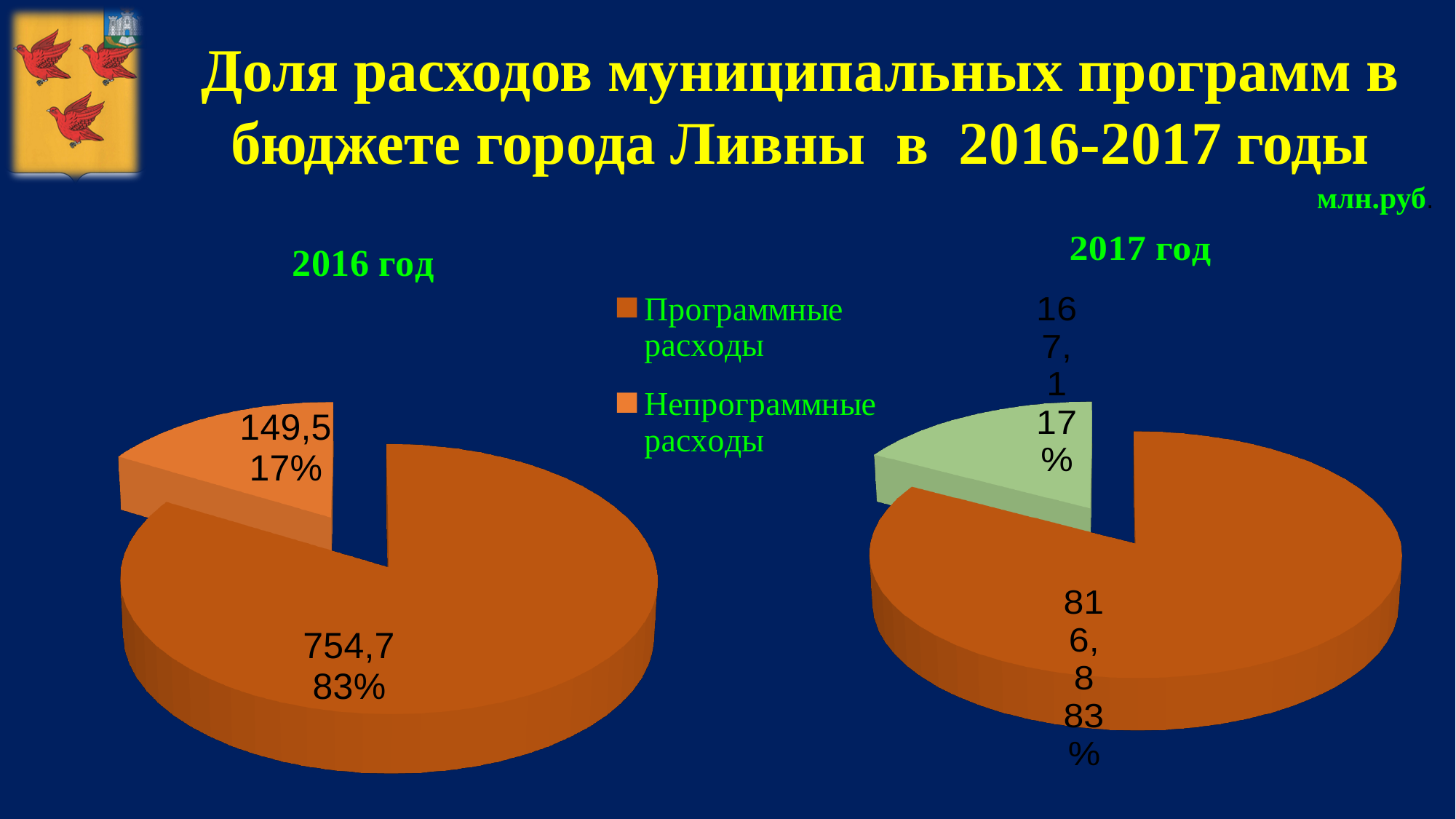
In the 2016 год chart, what is the value for Непрограммные расходы? 149,5 Which is larger: Программные расходы in 2016 год or Программные расходы in 2017 год? 2017 год What type of chart is used for the 2016 год chart? pie chart In the 2017 год chart, what share of the pie is Программные расходы? 83% How many entries does the legend list? 2 In the 2016 год chart, what share of the pie is Непрограммные расходы? 17% In the 2017 год chart, what is the value for Программные расходы? 816,8 In the 2016 год chart, what is the difference between Программные расходы and Непрограммные расходы? 605,2 In the 2017 год chart, which category is the smallest? Непрограммные расходы In the 2017 год chart, what is the value for Непрограммные расходы? 167,1 In the 2016 год chart, what is the value for Программные расходы? 754,7 In the 2016 год chart, which category is the largest? Программные расходы